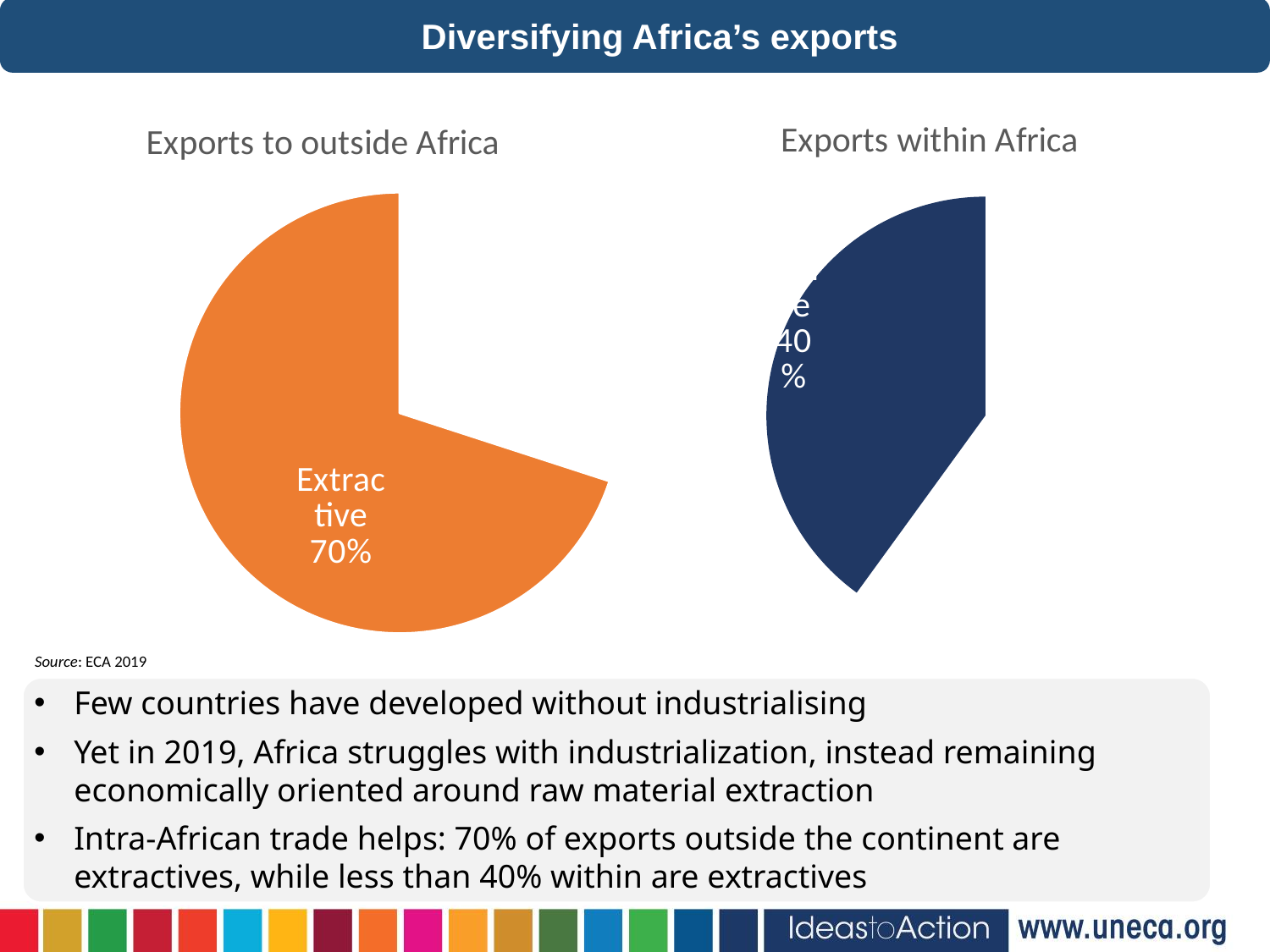
What kind of chart is the 'Exports to outside Africa' chart? Pie chart In the 'Exports within Africa' chart, what percentage value is printed on the slice label? 40% Which chart shows a larger share for extractives, 'Exports to outside Africa' or 'Exports within Africa'? Exports to outside Africa What colour is the Extractive slice in the 'Exports to outside Africa' chart? Orange In the 'Exports to outside Africa' chart, is the Extractive slice greater or less than 50% of the pie? greater In the 'Exports to outside Africa' chart, what share is labelled for Extractive? 70% What is the difference between the extractive share in 'Exports to outside Africa' (70%) and the share labelled in 'Exports within Africa' (40%)? 30 percentage points How many pie charts are shown on the slide? 2 In the 'Exports to outside Africa' chart, what percentage of the pie does the Extractive slice represent? 70% What is the title of the chart on the right side of the slide? Exports within Africa